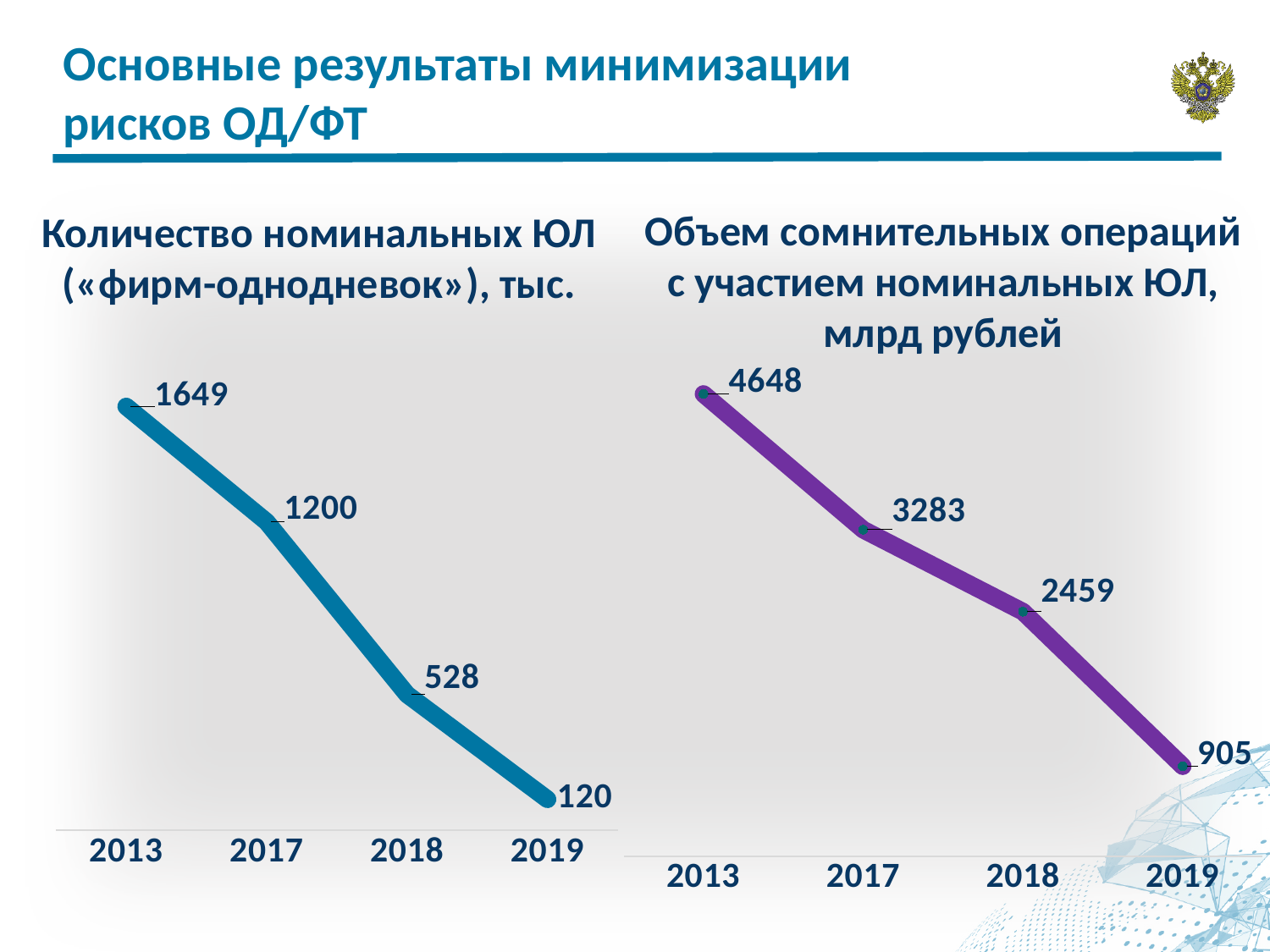
In the left chart (Количество номинальных ЮЛ), do the values rise or fall from 2013 to 2019? fall In the left chart (Количество номинальных ЮЛ), which year has the highest value? 2013 In the left chart (Количество номинальных ЮЛ), what is the value for 2019? 120 In the left chart (Количество номинальных ЮЛ), what is the difference between the 2017 and 2018 values? 672 In the left chart (Количество номинальных ЮЛ), what is the value for 2013? 1649 How many data points are plotted in the left chart (Количество номинальных ЮЛ)? 4 In the right chart (Объем сомнительных операций), what is the difference between the 2013 and 2019 values? 3743 In the right chart (Объем сомнительных операций), which is larger: the value for 2018 or the value for 2019? 2018 In the right chart (Объем сомнительных операций), what is the value for 2019? 905 What kind of chart is the right chart (Объем сомнительных операций)? line chart In the right chart (Объем сомнительных операций), which year has the lowest value? 2019 In the right chart (Объем сомнительных операций), what is the value for 2017? 3283